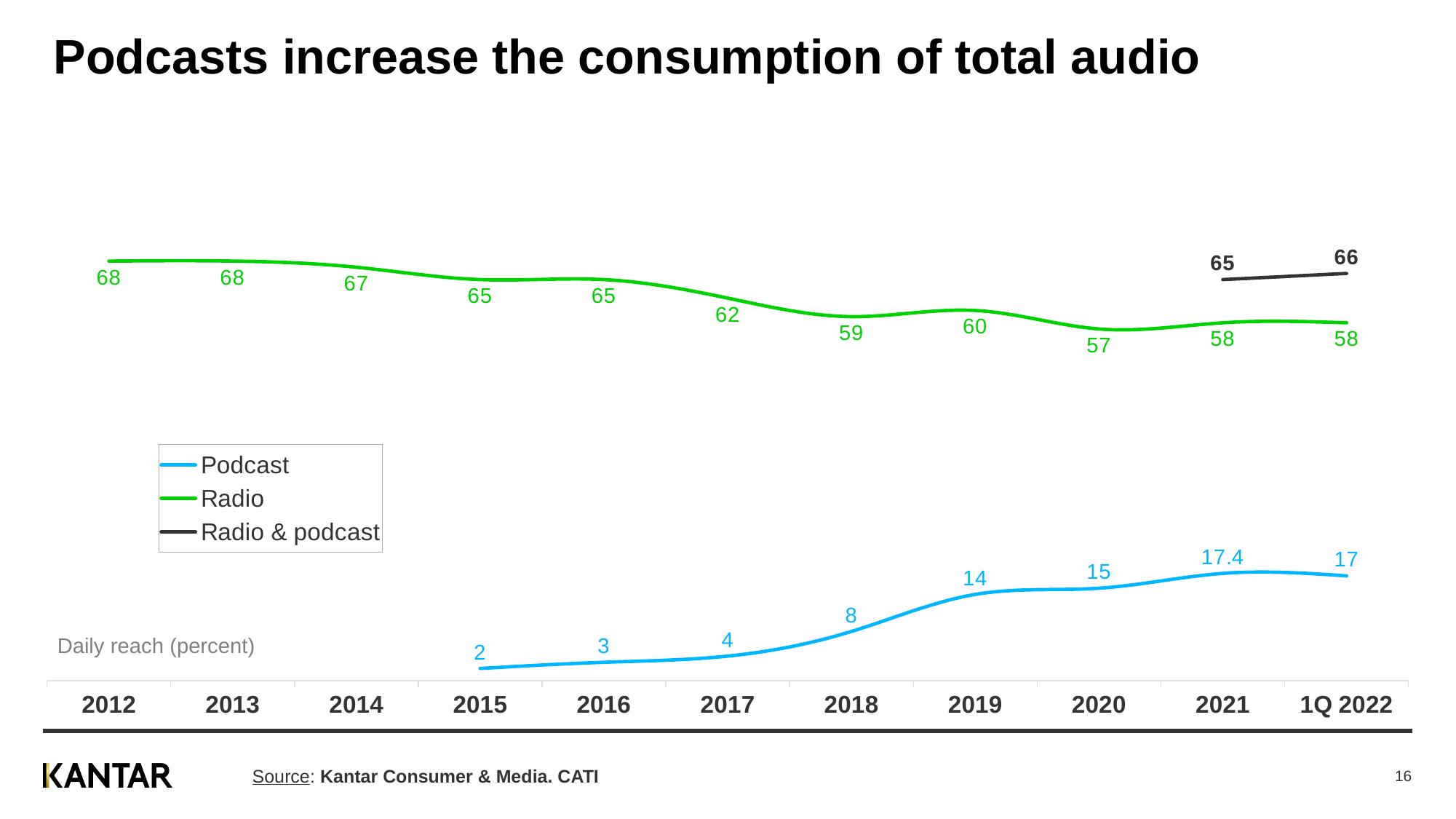
What kind of chart is shown on the slide? Line chart What is the Radio & podcast value for 1Q 2022? 66 How many time periods are shown on the x axis? 11 How many series does the legend list? 3 What is the Radio daily reach value for 2012? 68 In which year is the Podcast series at its highest? 2021 Does the Radio series generally rise or fall from 2012 to 1Q 2022? Fall What is the Podcast daily reach value for 2021? 17.4 In which year is the Radio series at its lowest? 2020 What is the difference between the Radio value in 2012 and in 1Q 2022? 10 What is the Radio value for 2020? 57 Which is larger in 2019: the Radio value or the Podcast value? Radio